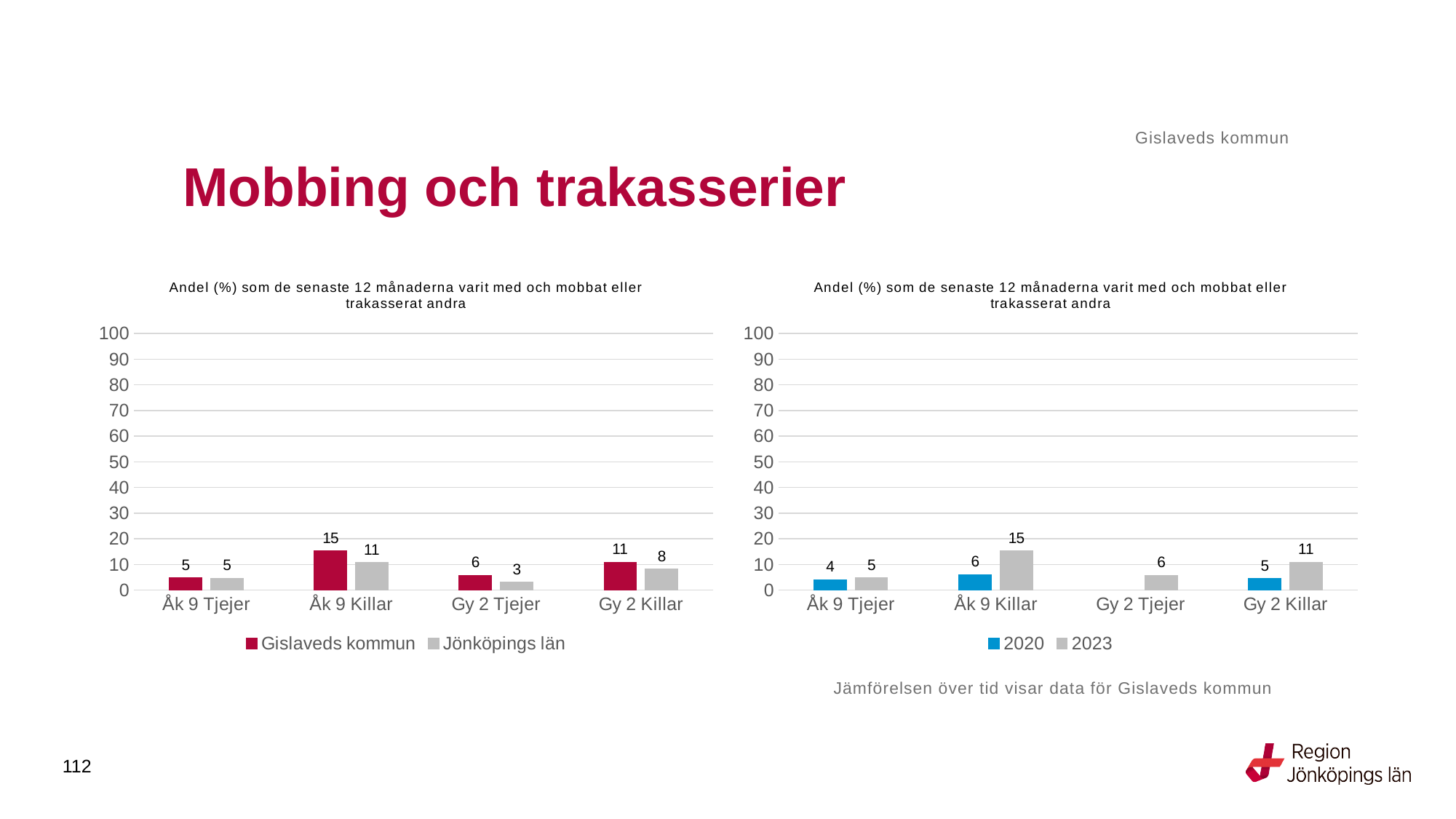
In the right chart, which category has the highest value for 2023? Åk 9 Killar What type of chart is the left chart? Bar chart In the right chart, what is the difference between 2023 and 2020 for Åk 9 Killar? 9 In the left chart, what is the value for Jönköpings län for Gy 2 Tjejer? 3 In the left chart, which is larger for Åk 9 Killar: Gislaveds kommun or Jönköpings län? Gislaveds kommun In the right chart, what is the value for 2023 for Gy 2 Killar? 11 How many series does the legend of the right chart list? 2 In the left chart, which category has the lowest value for Jönköpings län? Gy 2 Tjejer In the left chart, which category has the highest value for Gislaveds kommun? Åk 9 Killar In the left chart, what is the value for Gislaveds kommun for Åk 9 Killar? 15 In the left chart, what is the difference between Gislaveds kommun and Jönköpings län for Gy 2 Killar? 3 In the right chart, what is the value for 2020 for Åk 9 Tjejer? 4